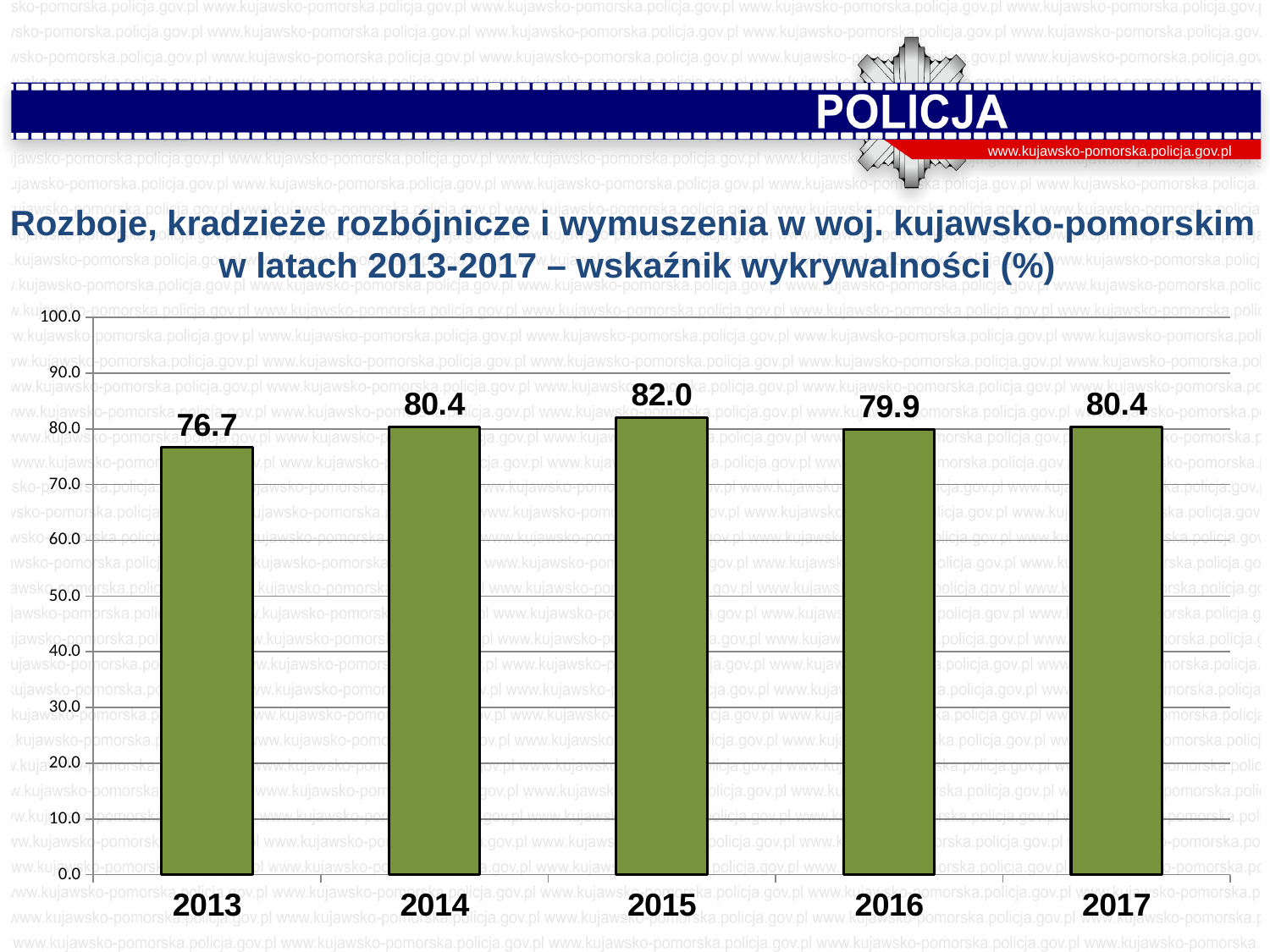
What is the difference between the values for 2015 and 2013? 5.3 Which is larger, the value for 2013 or the value for 2016? 2016 What is the detection rate value shown for 2013? 76.7 What is the value shown for 2015? 82.0 What is the difference between the values for 2014 and 2016? 0.5 What is the maximum value shown on the y axis? 100.0 Is the value for 2013 greater or less than 80.0? less Which year has the lowest value? 2013 What is the value shown for 2016? 79.9 What kind of chart is shown on the slide? bar chart Which year has the highest value? 2015 How many years are shown on the x axis? 5